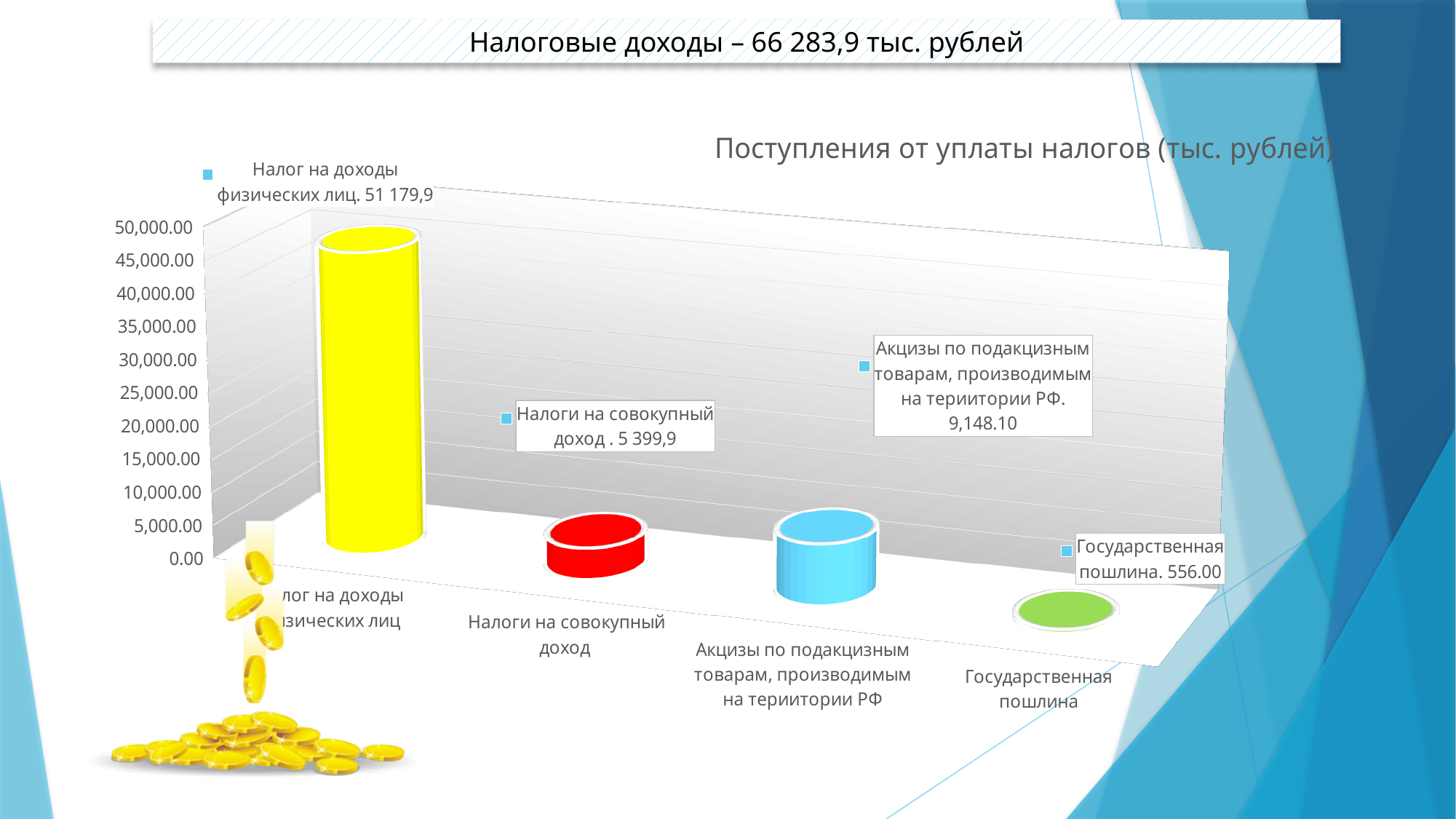
What is the value for Государственная пошлина? 556.00 Which category has the lowest value? Государственная пошлина Is the value for Налог на доходы физических лиц greater or less than 45,000.00? greater What kind of chart is shown on the slide? bar chart What is the value for Налоги на совокупный доход? 5 399,9 How many categories are shown in the chart? 4 Which category has the highest value? Налог на доходы физических лиц What is the value for Налог на доходы физических лиц? 51 179,9 What is the difference between Акцизы по подакцизным товарам (9,148.10) and Государственная пошлина (556.00)? 8,592.10 What is the title of the chart? Поступления от уплаты налогов (тыс. рублей) Which is larger: Акцизы по подакцизным товарам or Налоги на совокупный доход? Акцизы по подакцизным товарам What is the value for Акцизы по подакцизным товарам, производимым на территории РФ? 9,148.10